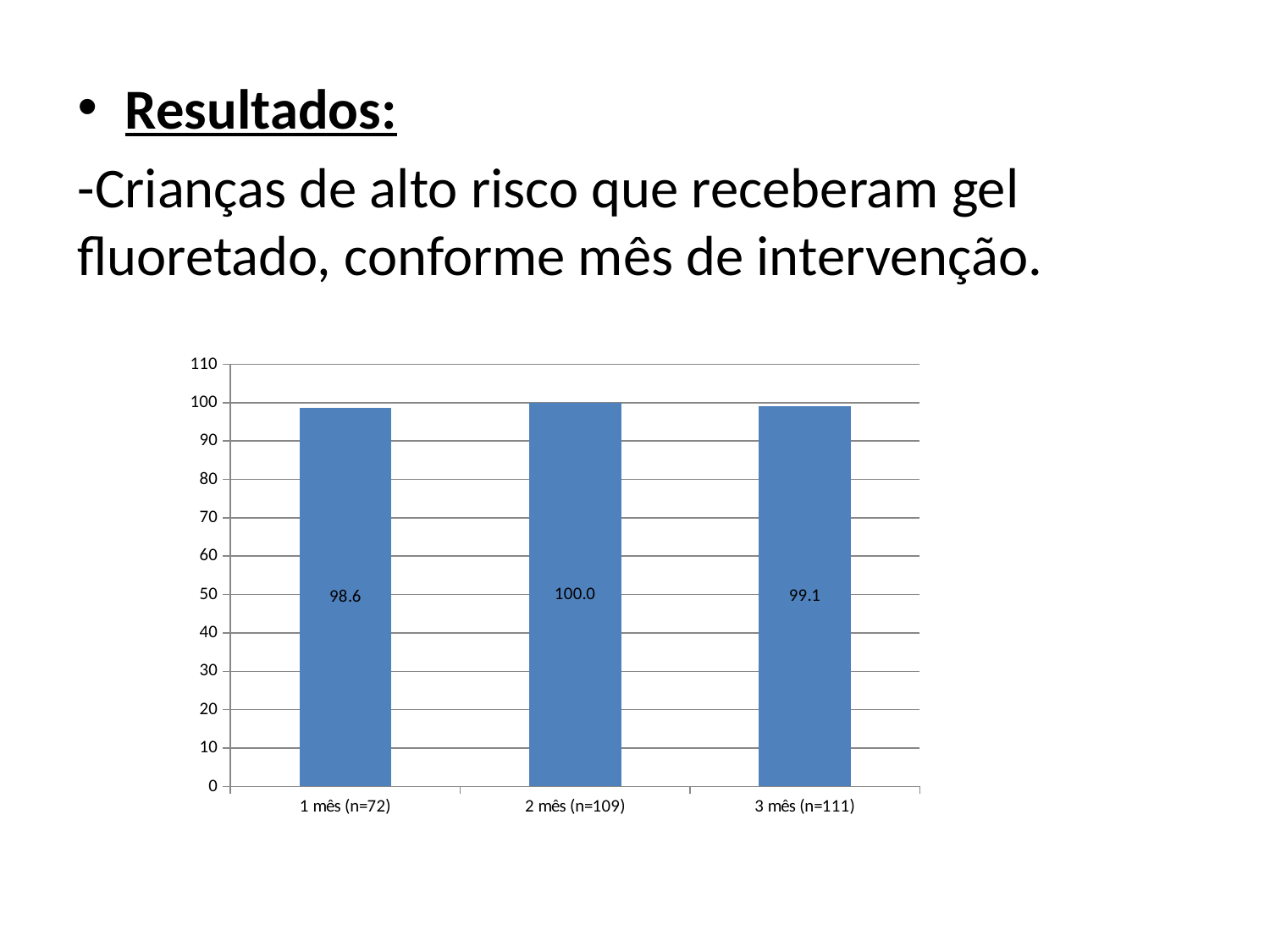
Which category has the highest value? 2 mês (n=109) What is the value for 3 mês (n=111)? 99.1 What kind of chart is shown on the slide? bar chart What is the highest value shown on the y axis? 110 What is the value for 2 mês (n=109)? 100.0 Which is larger, the value for 3 mês (n=111) or the value for 1 mês (n=72)? 3 mês (n=111) Which category has the lowest value? 1 mês (n=72) What is the value for 1 mês (n=72)? 98.6 What is the difference between the values for 3 mês (n=111) and 1 mês (n=72)? 0.5 How many categories are shown on the x axis? 3 What is the difference between the values for 2 mês (n=109) and 1 mês (n=72)? 1.4 Is the value for 1 mês (n=72) greater or less than 90? greater